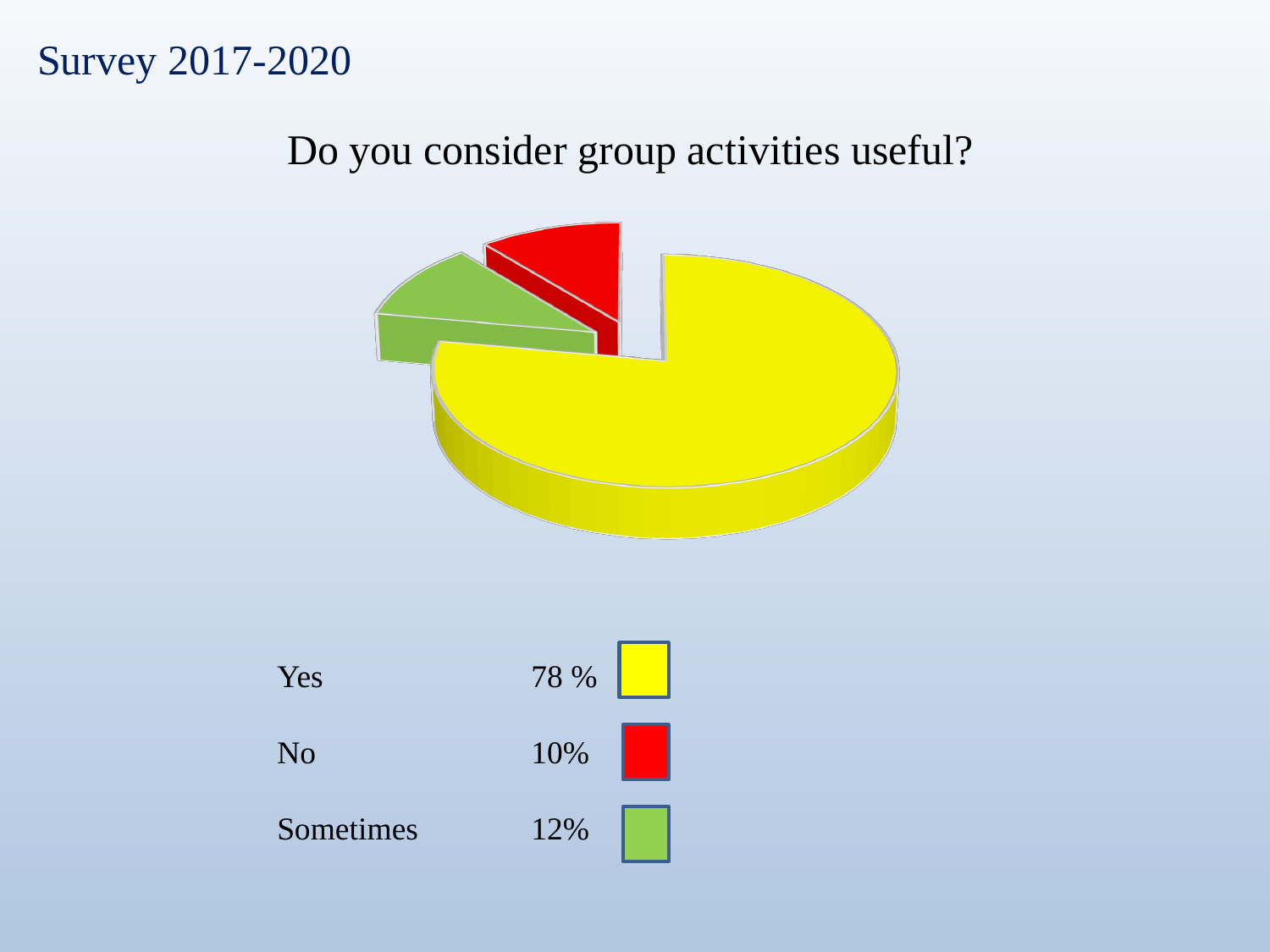
What question does the pie chart's title ask? Do you consider group activities useful? What percentage of respondents answered "No"? 10% What percentage of respondents answered "Yes" to whether group activities are useful? 78 % What kind of chart is shown on the slide? pie chart What is the difference in percentage points between the "Sometimes" and "No" responses? 2 Which is larger, the share for "Sometimes" or the share for "No"? Sometimes Which response has the smallest share of the pie? No What percentage of respondents answered "Sometimes"? 12% What is the difference in percentage points between the "Yes" and "No" responses? 68 Which colour represents the "No" response in the pie chart? red How many slices does the pie chart have? 3 Which response has the largest share of the pie? Yes